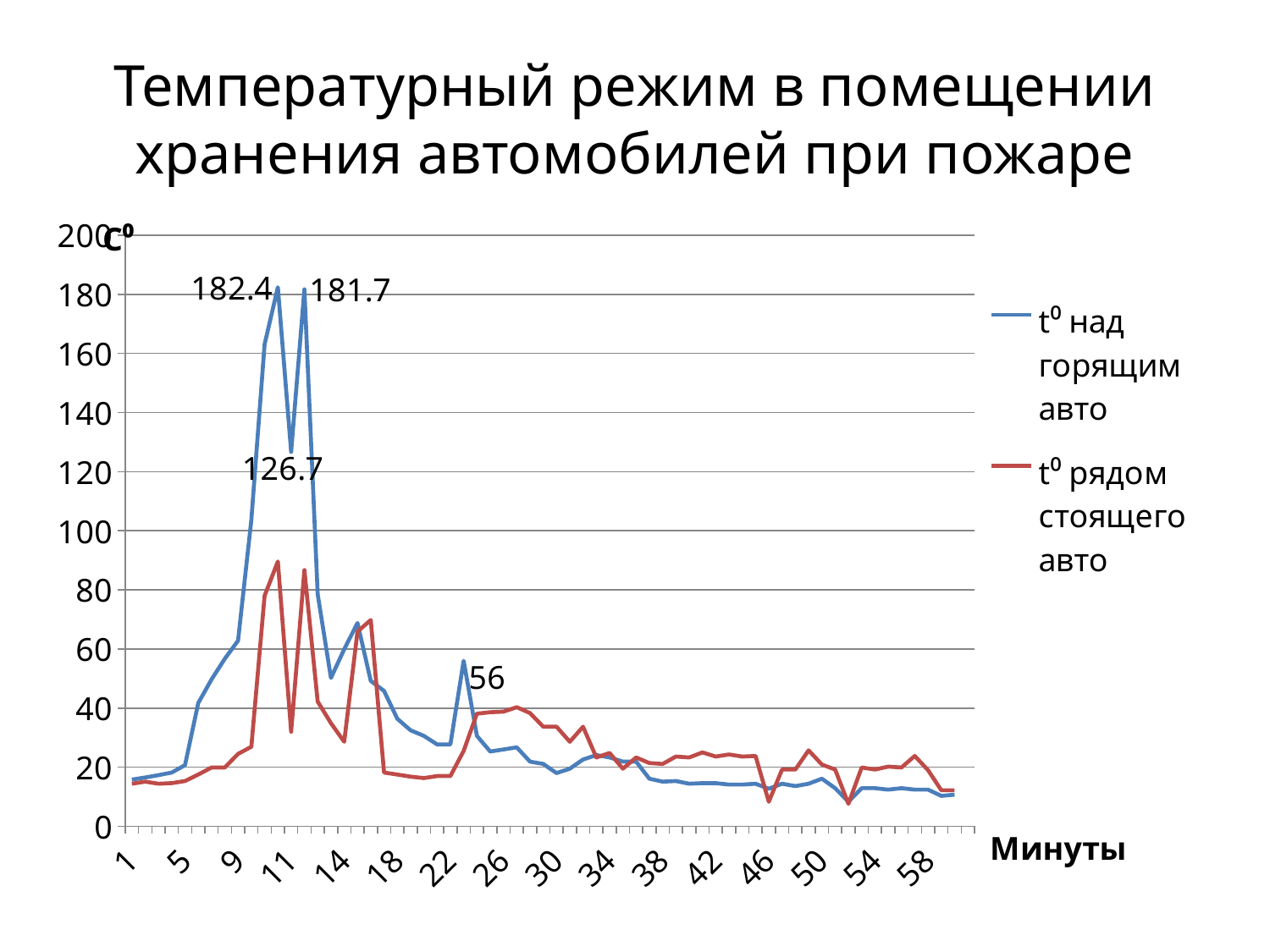
Which series reaches the highest temperature on the chart? t⁰ над горящим авто Around minute 26 to 30, which series is higher: t⁰ над горящим авто or t⁰ рядом стоящего авто? t⁰ рядом стоящего авто What kind of chart is shown on the slide? line chart What is the label of the x axis? Минуты What is the value of the second labelled peak of the t⁰ над горящим авто line? 181.7 What is the difference between the two labelled peaks, 182.4 and 181.7? 0.7 What is the highest labelled value on the line for t⁰ над горящим авто? 182.4 How many series does the legend list? 2 Is the highest value of the t⁰ рядом стоящего авто line greater or less than 100? less What is the labelled value of the small spike on the t⁰ над горящим авто line around minute 23? 56 What is the labelled value of the dip between the two peaks of the t⁰ над горящим авто line? 126.7 What is the difference between the labelled peak 182.4 and the labelled dip 126.7? 55.7